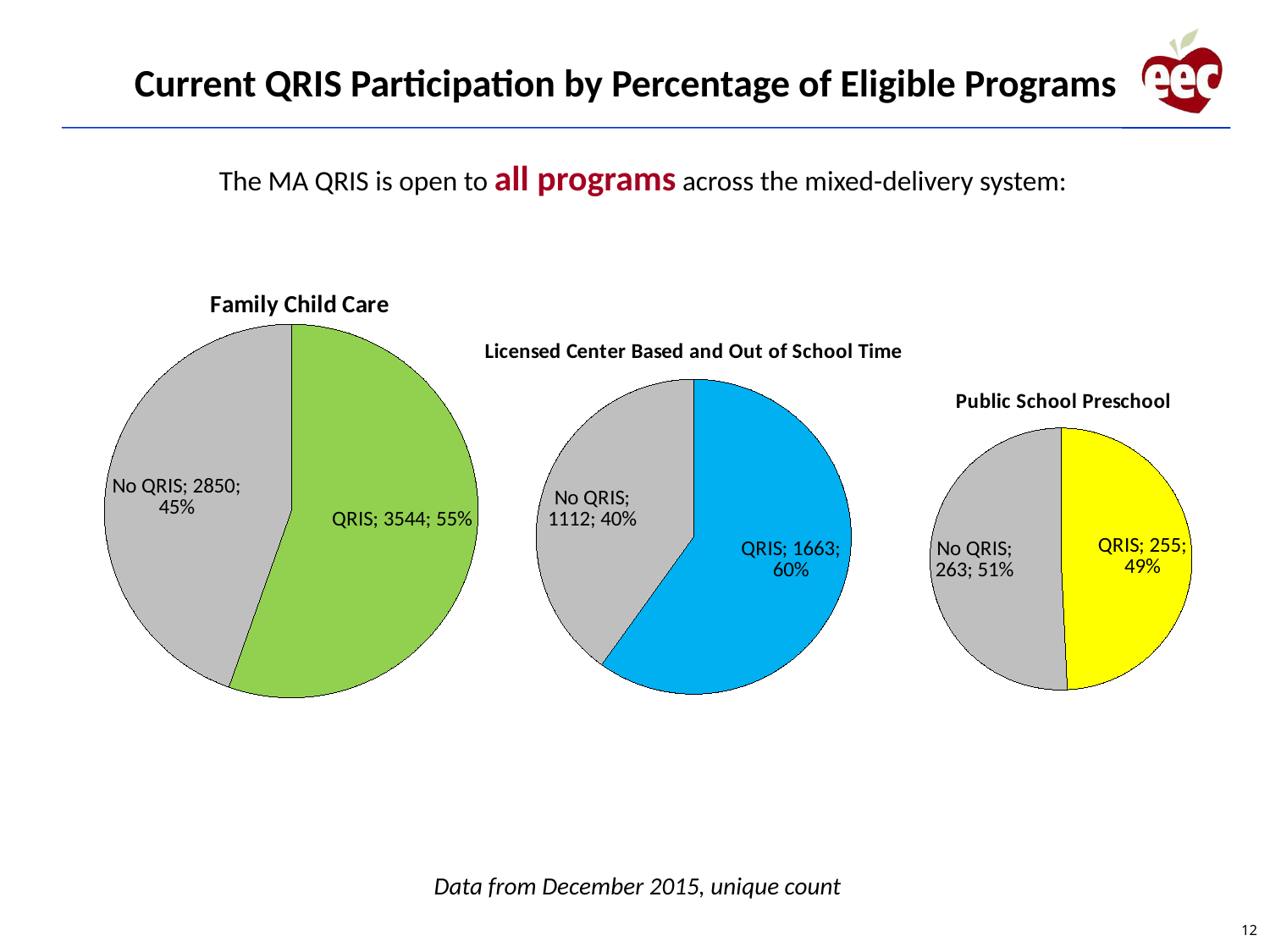
In the Licensed Center Based and Out of School Time chart, what is the value for QRIS? 1663 In the Family Child Care chart, what is the difference between the QRIS and No QRIS values? 694 In the Licensed Center Based and Out of School Time chart, which slice is larger, QRIS or No QRIS? QRIS What kind of chart is the Family Child Care chart? Pie chart In the Public School Preschool chart, what share of the pie is QRIS? 49% In the Licensed Center Based and Out of School Time chart, what share of the pie is No QRIS? 40% In the Public School Preschool chart, what is the value for No QRIS? 263 In the Family Child Care chart, what is the value for No QRIS? 2850 In the Family Child Care chart, what is the value for QRIS? 3544 In the Licensed Center Based and Out of School Time chart, what is the difference between the QRIS and No QRIS values? 551 In the Family Child Care chart, what share of the pie is QRIS? 55% How many slices does the Public School Preschool chart have? 2